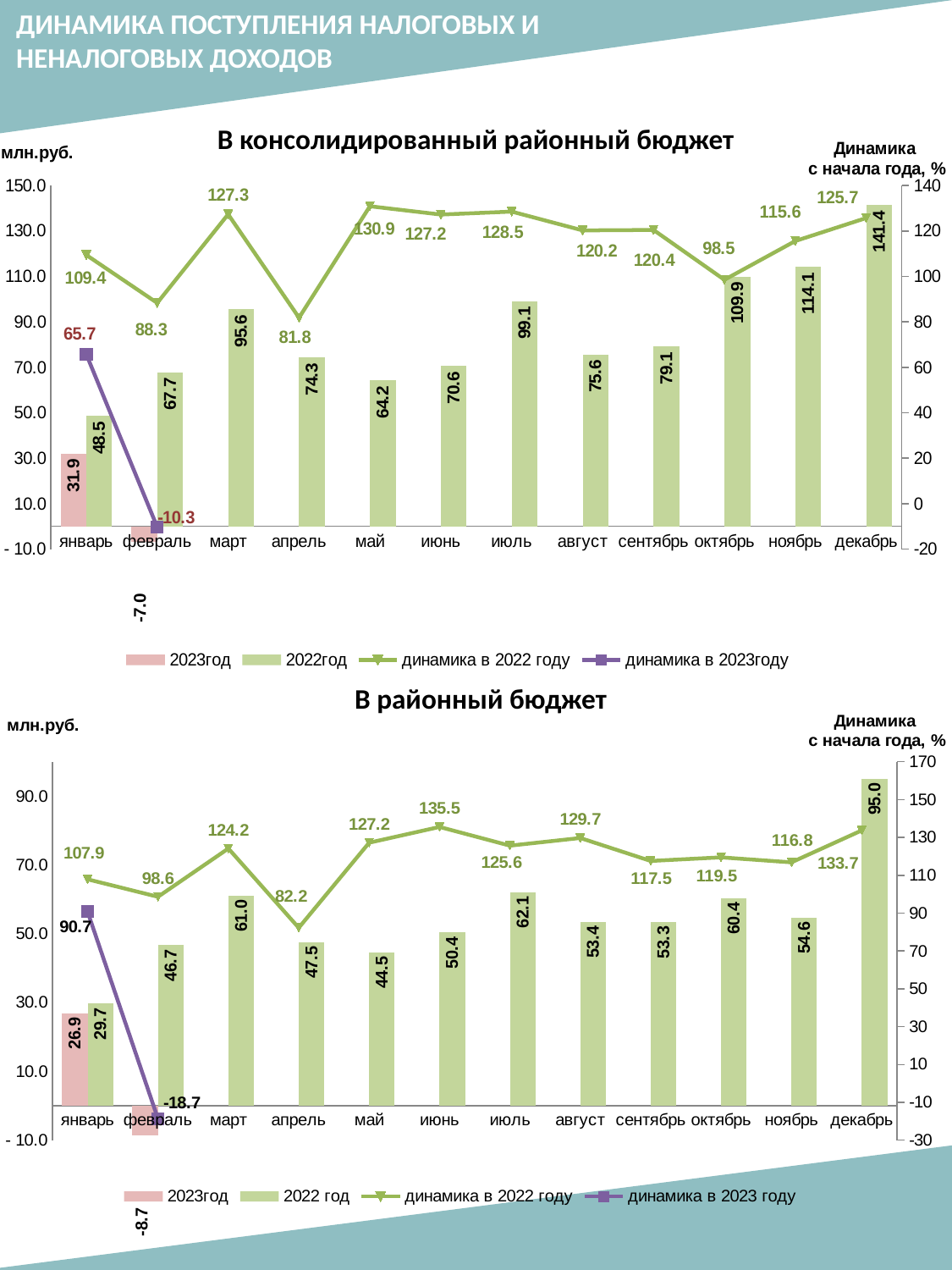
In the chart 'В районный бюджет', what is the value of 'динамика в 2023 году' for февраль? -18.7 In the chart 'В консолидированный районный бюджет', what is the value of the 2022год bar for декабрь? 141.4 In the chart 'В районный бюджет', which month has the lowest 2022 год bar? январь In the chart 'В районный бюджет', which is larger: the 2022 год bar for март or for апрель? март In the chart 'В районный бюджет', what is the value of the 2022 год bar for июль? 62.1 In the chart 'В консолидированный районный бюджет', which month has the highest 2022год bar? декабрь In the chart 'В консолидированный районный бюджет', what is the value of 'динамика в 2022 году' for апрель? 81.8 In the chart 'В консолидированный районный бюджет', what is the difference between the 2022год bars for ноябрь and октябрь? 4.2 In the chart 'В районный бюджет', how many months are shown on the x axis? 12 In the chart 'В консолидированный районный бюджет', how many series does the legend list? 4 In the chart 'В районный бюджет', what is the highest value of 'динамика в 2022 году'? 135.5 In the chart 'В консолидированный районный бюджет', what is the value of the 2023год bar for январь? 31.9